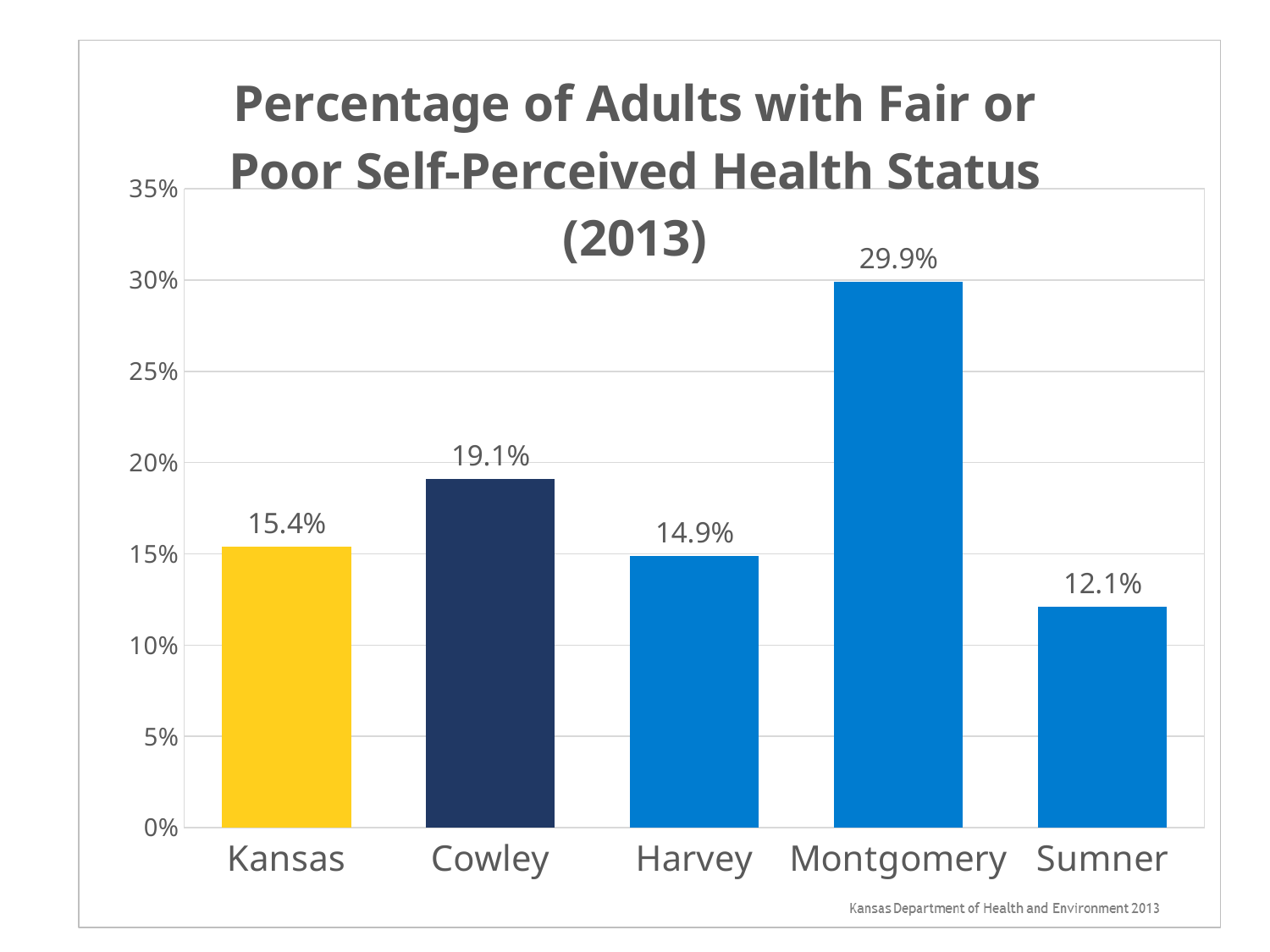
What is the difference between the values for Kansas and Sumner? 3.3% What is the title of the chart? Percentage of Adults with Fair or Poor Self-Perceived Health Status (2013) Which category has the lowest value? Sumner Which is larger, the value for Cowley or the value for Harvey? Cowley What is the value for Kansas? 15.4% What is the value for Sumner? 12.1% How many categories are shown on the x axis? 5 What is the difference between the values for Montgomery and Cowley? 10.8% Is the value for Montgomery greater or less than 25%? greater What kind of chart is shown on the slide? bar chart What is the value for Montgomery? 29.9% Which category has the highest value? Montgomery